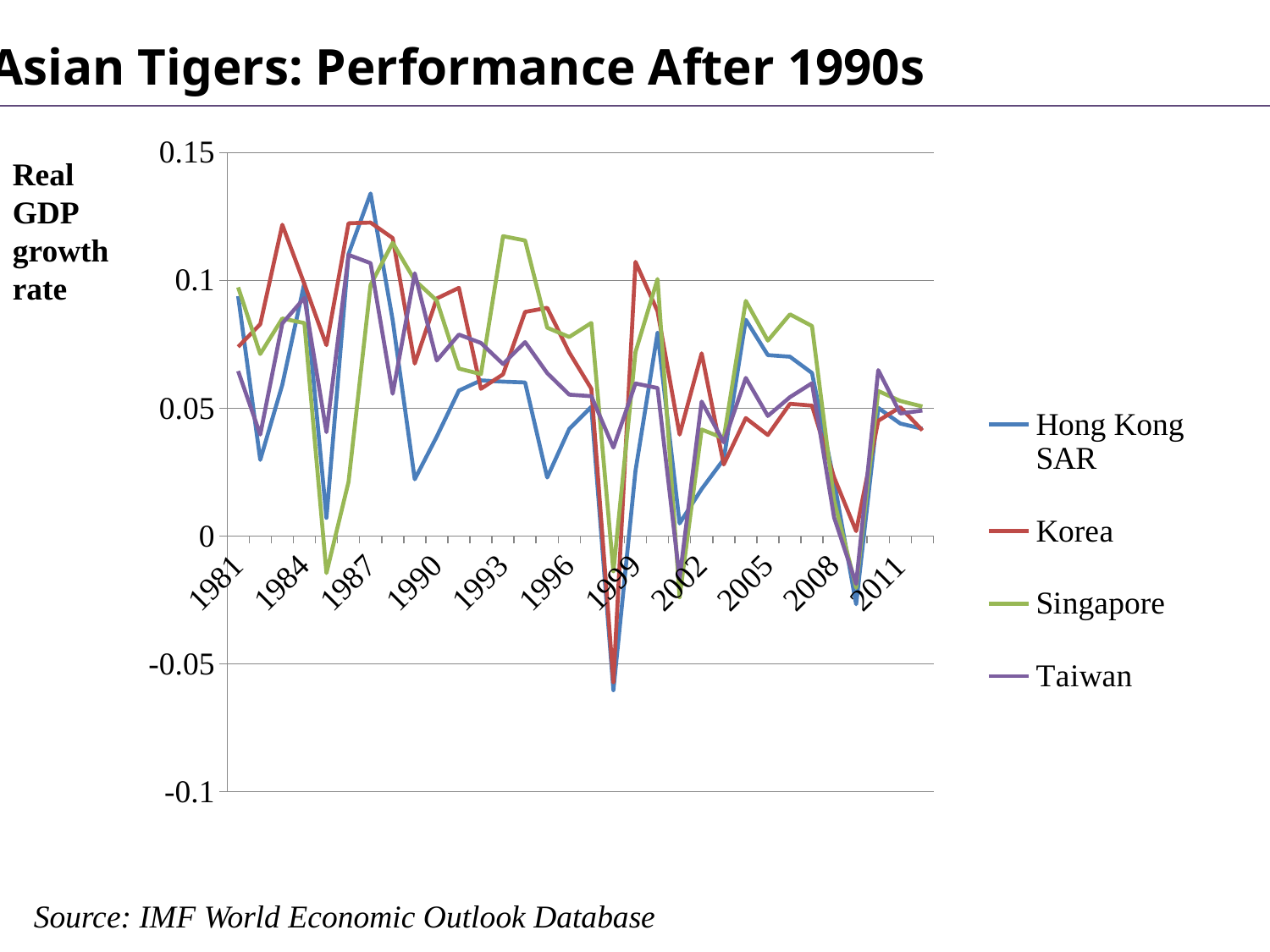
Overall, does the Korea line rise or fall from 1981 to 2011? fall Is the lowest value for Taiwan greater or less than 0? less Is the highest value for Hong Kong SAR greater or less than 0.1? greater Is the lowest value for Hong Kong SAR greater or less than -0.05? less What quantity does the y axis represent, according to the label on the slide? Real GDP growth rate How many series does the legend list? 4 In 1981, which is larger, the value for Singapore or the value for Taiwan? Singapore How many year labels are shown on the x axis? 11 Which series reaches the highest value anywhere on the chart? Hong Kong SAR Which series are listed in the legend? Hong Kong SAR, Korea, Singapore, Taiwan What kind of chart is shown on the slide? line chart